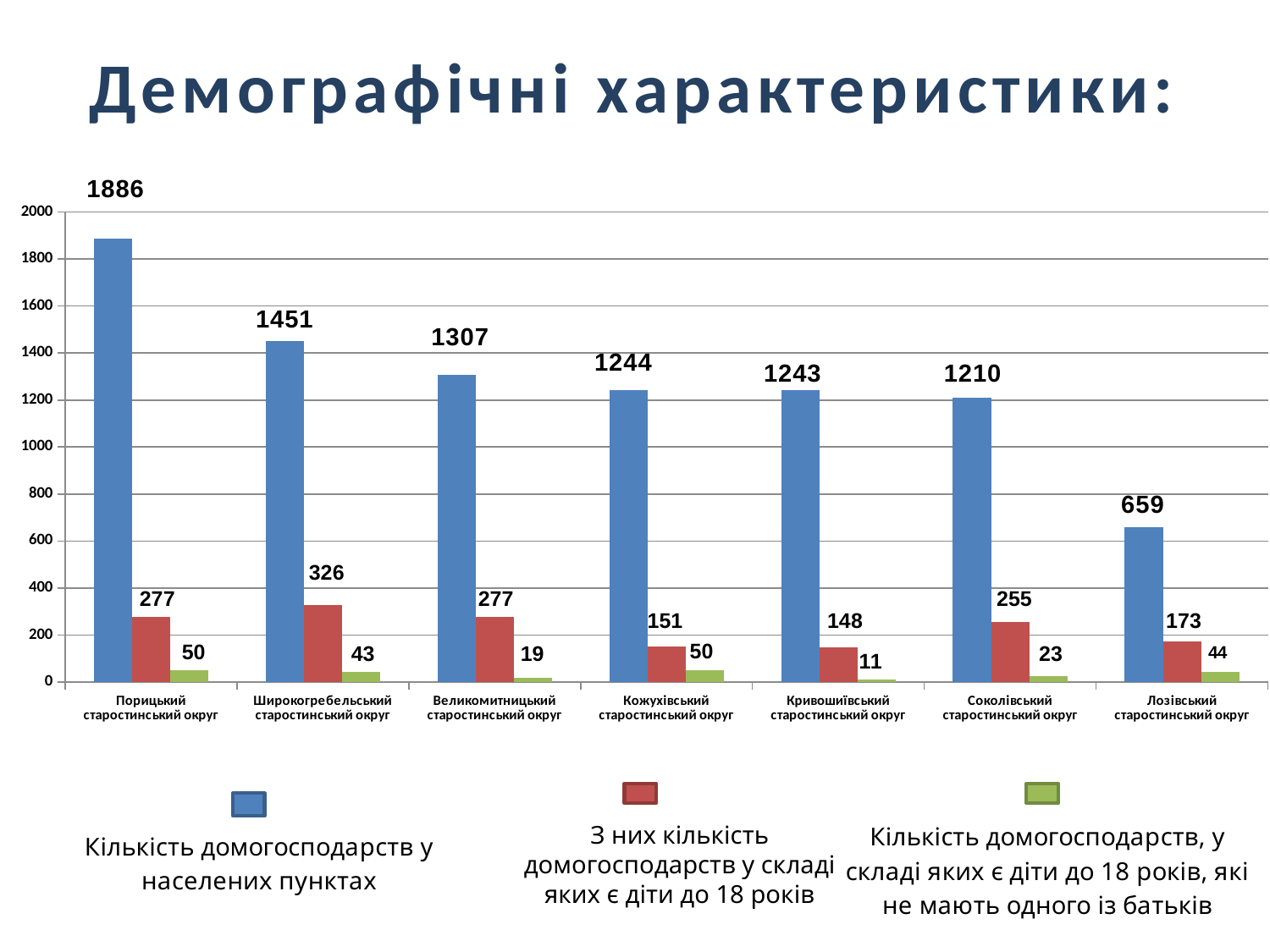
What is the title of the slide? Демографічні характеристики: How many districts (categories) are shown on the x axis? 7 How many series does the legend list? 3 Which district has a larger red-series value: Соколівський or Кожухівський? Соколівський старостинський округ What is the number of households (blue series) for Порицький старостинський округ? 1886 Which district has the highest number of households (blue series)? Порицький старостинський округ What is the difference between the number of households in Порицький and Лозівський districts (blue series)? 1227 What is the value of the red series (households with children under 18) for Широкогребельський старостинський округ? 326 Which district has the lowest number of households (blue series)? Лозівський старостинський округ Which district has the highest green-series value? Порицький старостинський округ and Кожухівський старостинський округ (both 50) What type of chart is shown on the slide? Bar chart What is the value of the green series (single-parent households with children) for Кривошиївський старостинський округ? 11